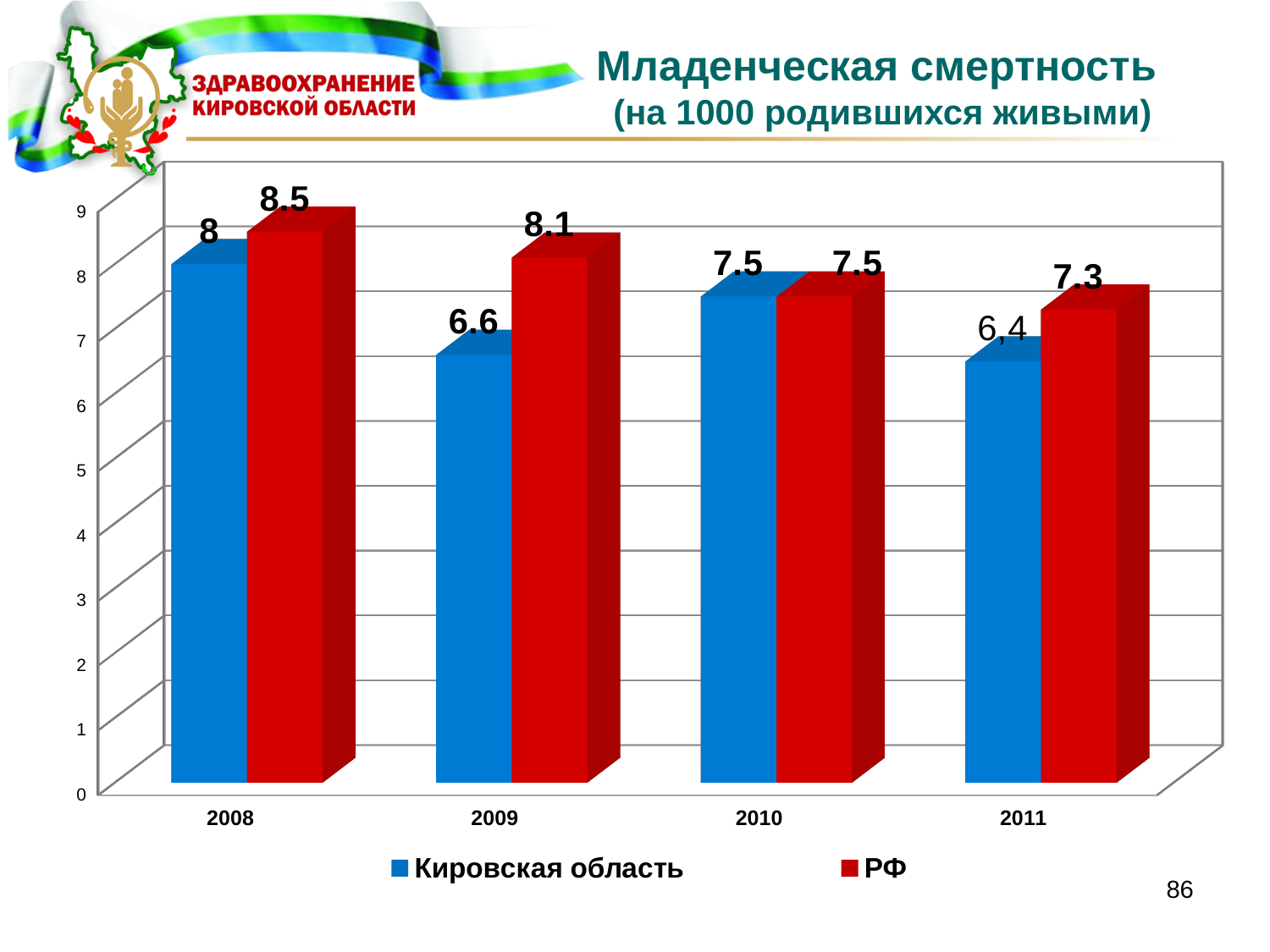
In which year is the value for Кировская область lowest? 2011 What is the difference between the РФ and Кировская область values in 2009? 1.5 Which is larger in 2008: the value for Кировская область or for РФ? РФ Does the value for РФ rise or fall from 2008 to 2011? fall How many years are shown on the x axis? 4 In which year is the value for РФ highest? 2008 What is the value for Кировская область in 2008? 8 What is the value for РФ in 2009? 8.1 What is the value for Кировская область in 2011? 6,4 How many series does the legend list? 2 What is the value for РФ in 2011? 7.3 What kind of chart is shown on the slide? bar chart